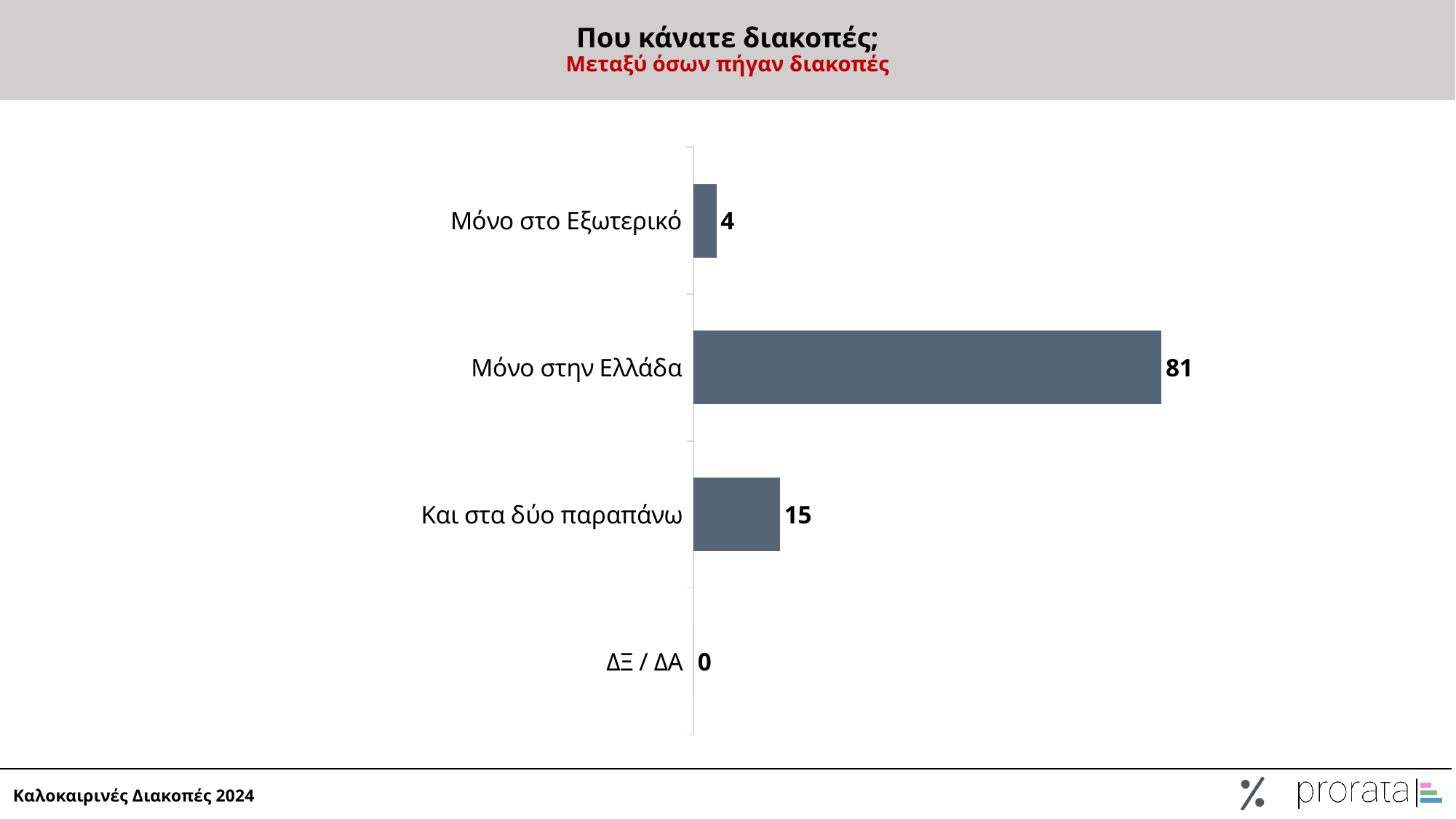
Which category has the lowest value? ΔΞ / ΔΑ What is the difference between the values for Μόνο στην Ελλάδα and Και στα δύο παραπάνω? 66 How many categories are shown in the chart? 4 Which is larger, the value for Μόνο στο Εξωτερικό or the value for Και στα δύο παραπάνω? Και στα δύο παραπάνω What is the value for Μόνο στο Εξωτερικό? 4 What is the value for Και στα δύο παραπάνω? 15 What is the value for ΔΞ / ΔΑ? 0 What is the value for Μόνο στην Ελλάδα? 81 Which category has the highest value? Μόνο στην Ελλάδα What is the difference between the values for Και στα δύο παραπάνω and Μόνο στο Εξωτερικό? 11 What kind of chart is shown on the slide? Bar chart What is the main title of the chart? Που κάνατε διακοπές;